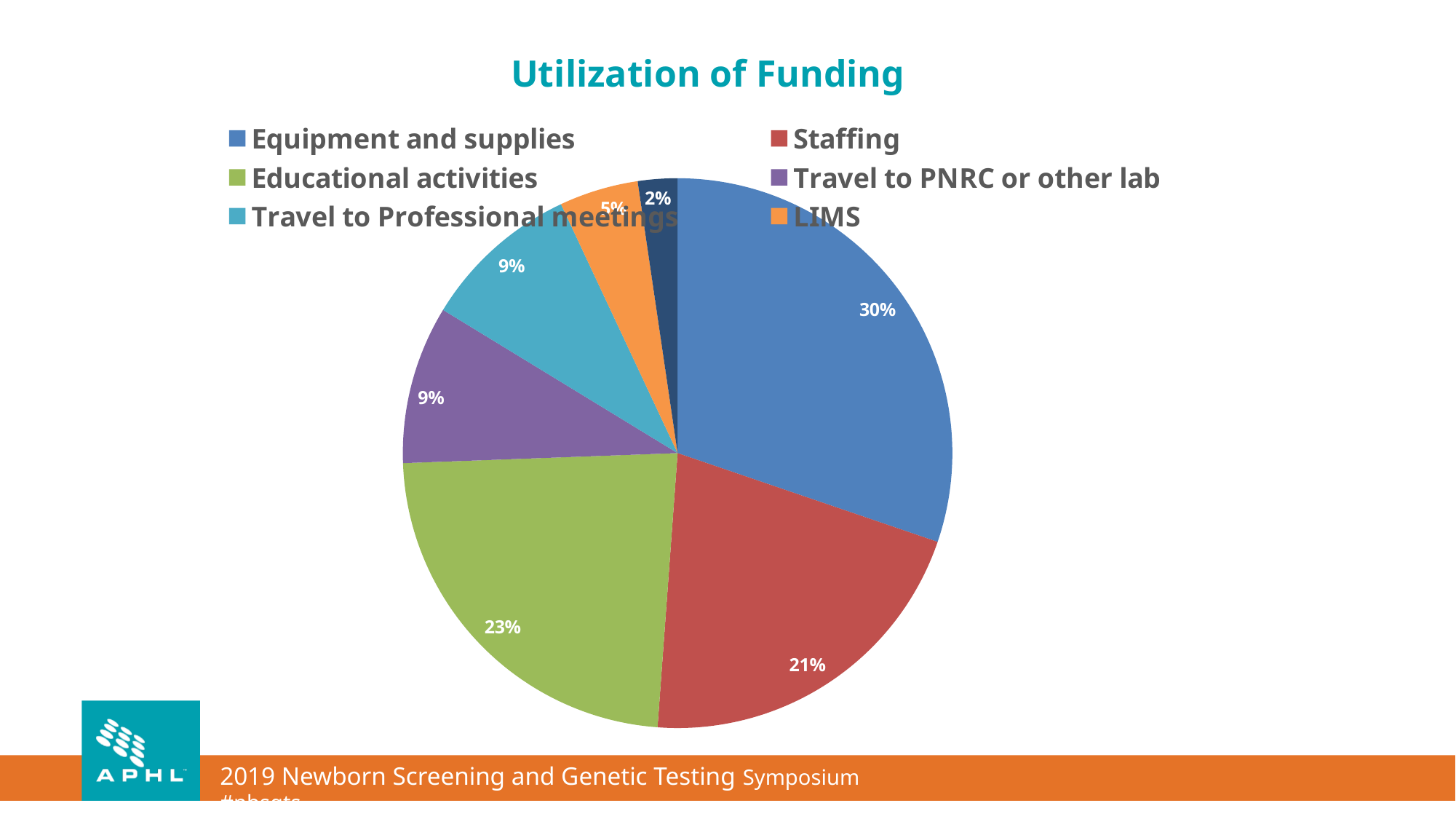
What is the difference between the share for Equipment and supplies and the share for Staffing? 9% What share of funding goes to Travel to PNRC or other lab? 9% What share of funding goes to LIMS? 5% What type of chart is shown on the slide? pie chart Which category has the largest share of funding? Equipment and supplies What share of funding goes to Equipment and supplies? 30% What share of funding goes to Staffing? 21% What is the smallest percentage shown on the chart? 2% Which is larger, the share for Staffing or the share for Educational activities? Educational activities What share of funding goes to Educational activities? 23% How many entries does the legend list? 6 What is the title of the chart? Utilization of Funding